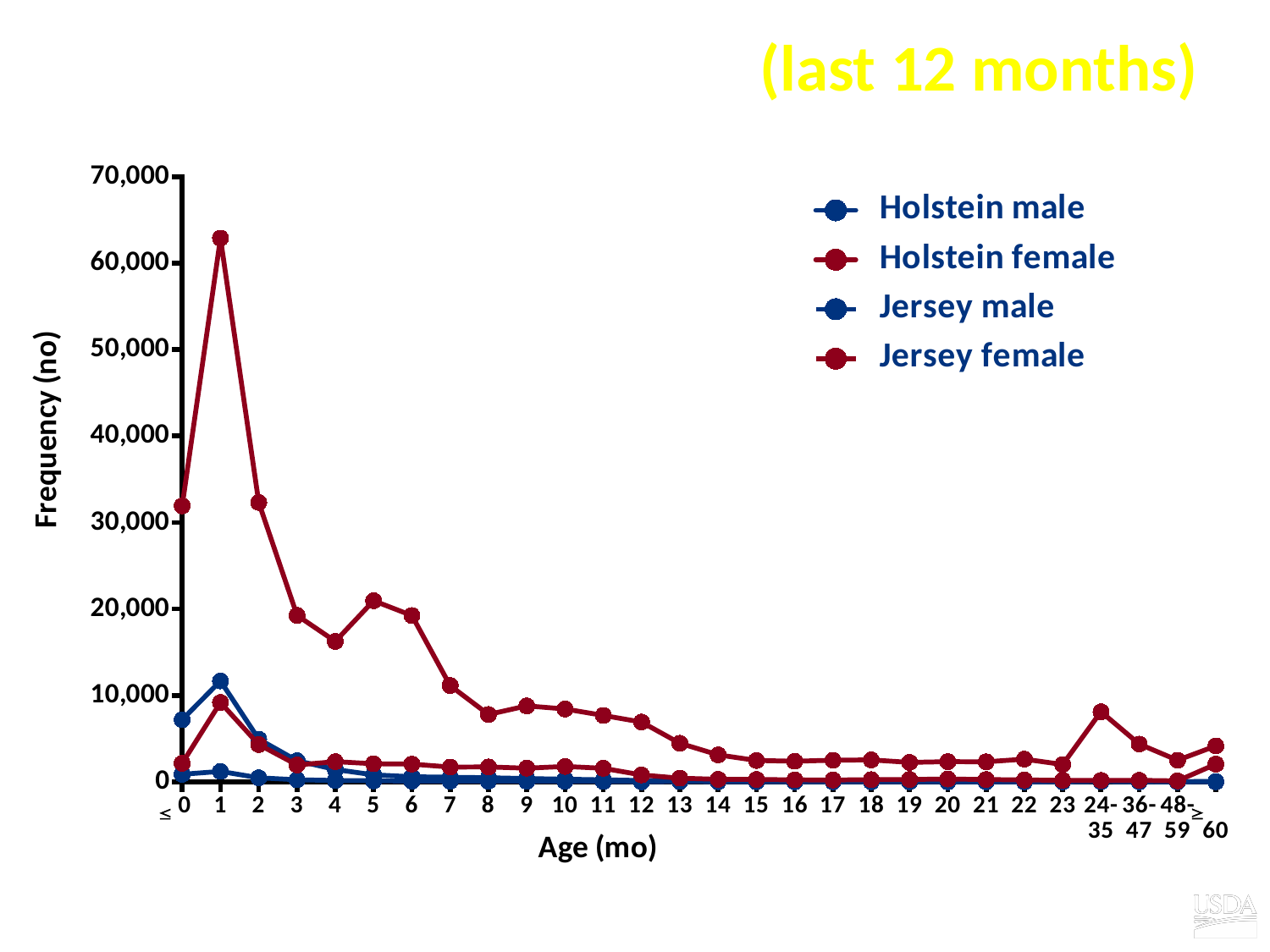
How many age categories are shown along the x axis? 28 What is the label of the y axis? Frequency (no) Is the highest point on the chart, at age 1, greater or less than 60,000? greater What is the label of the x axis? Age (mo) Is the value of the top line at age 3 greater or less than 20,000? less What kind of chart is shown on the slide? line chart Is the value of the top line at age 5 greater or less than 20,000? greater Which is larger for the top line: the value at age 1 or the value at age 2? age 1 Between age 1 and age 4, does the top line rise or fall? fall At which age (mo) does the chart reach its highest frequency? 1 How many series does the legend list? 4